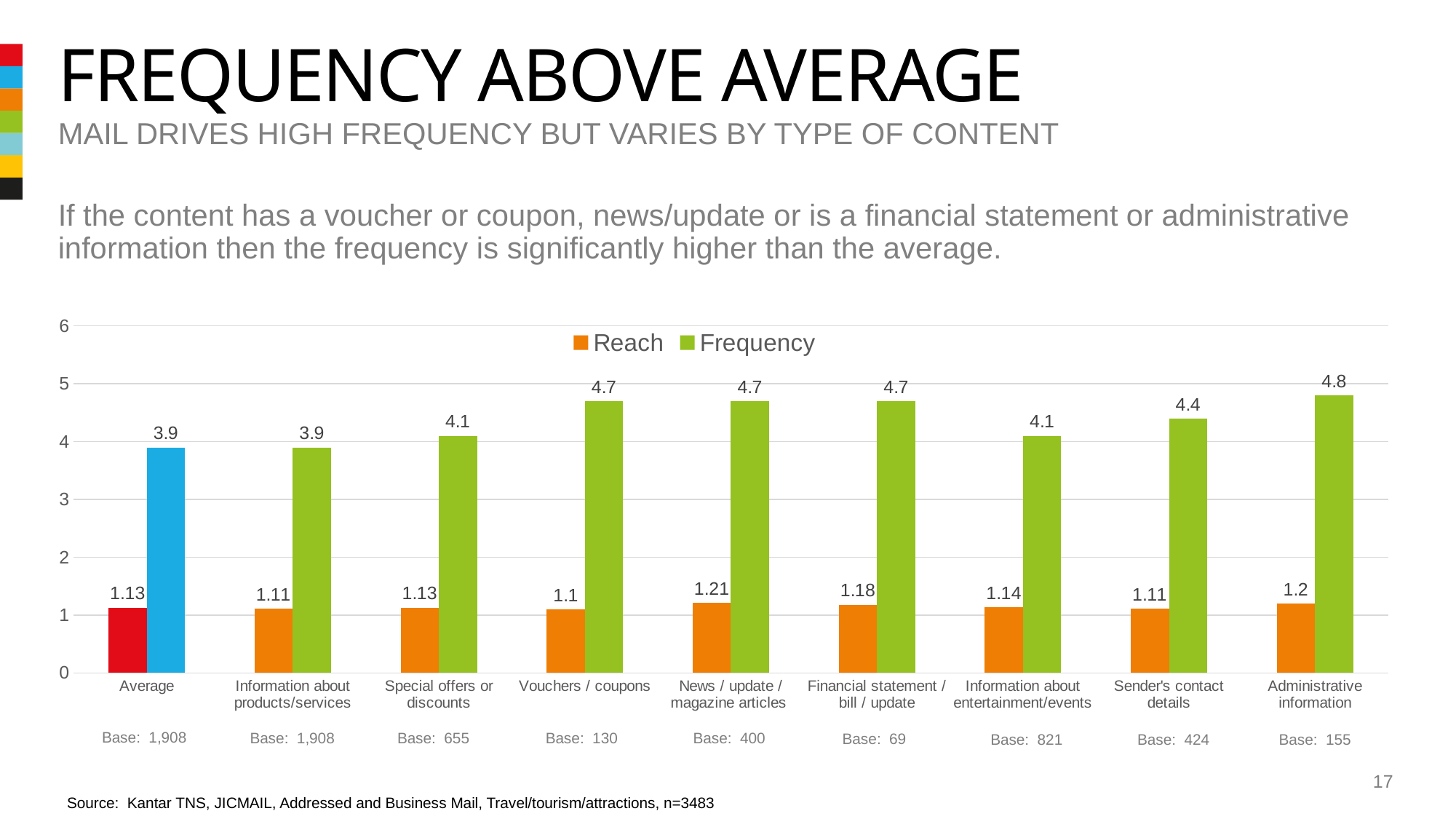
What kind of chart is shown on the slide? Bar chart What is the Frequency value for Average? 3.9 What is the difference between the Frequency values for Administrative information and Average? 0.9 Which category has the highest Frequency value? Administrative information What is the Reach value for News / update / magazine articles? 1.21 Which category has the lowest Reach value? Vouchers / coupons Is the Frequency value for Vouchers / coupons greater or less than 4? greater What is the Base shown for Financial statement / bill / update? 69 How many categories are shown on the x axis? 9 How many series does the legend list? 2 What is the Frequency value for Administrative information? 4.8 Which is larger, the Frequency value for Sender's contact details or for Special offers or discounts? Sender's contact details